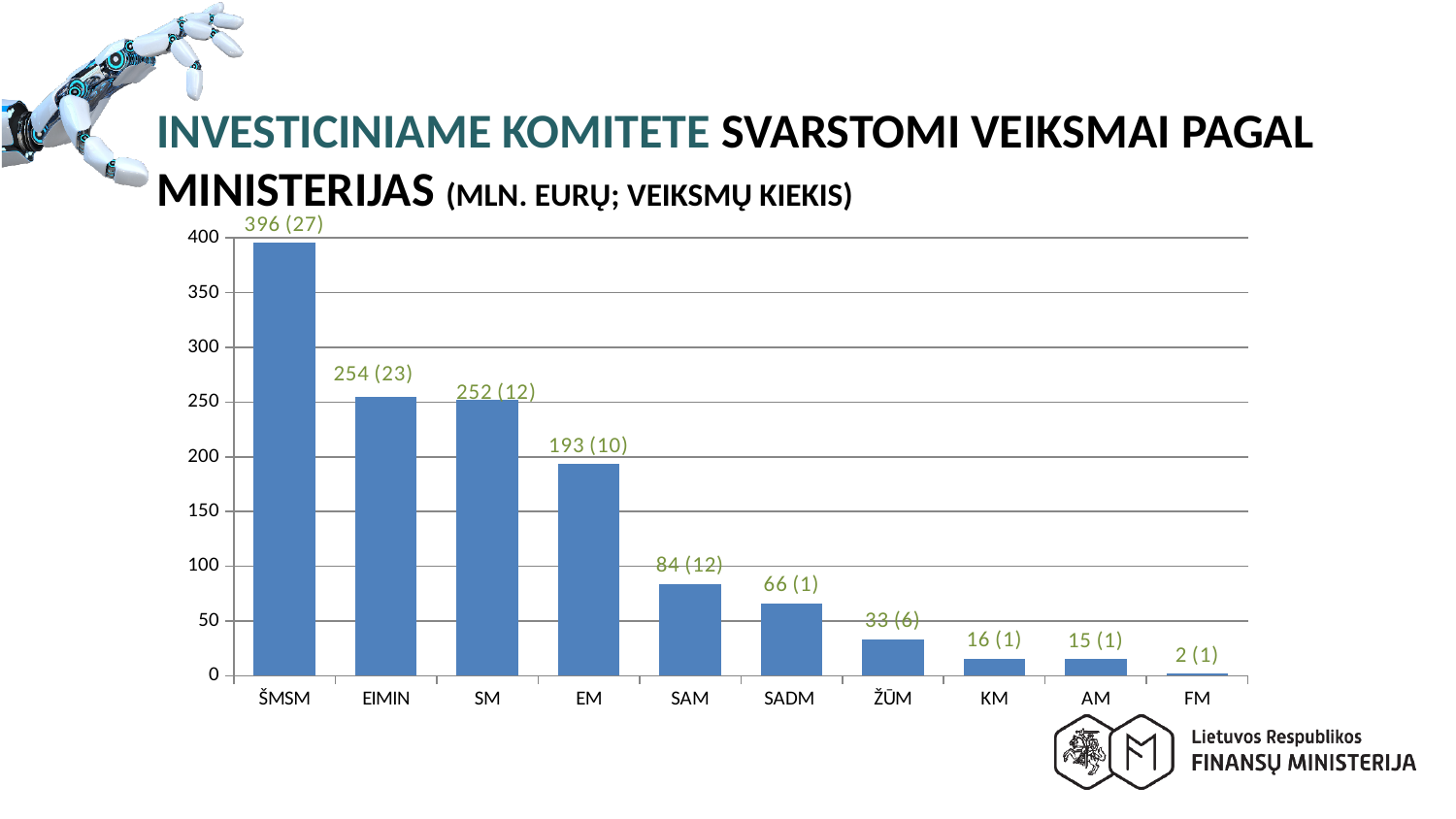
What is the data label shown for ŠMSM? 396 (27) What is the difference in mln eurų between ŠMSM (396) and EIMIN (254)? 142 What type of chart is shown on the slide? bar chart What is the data label shown for ŽŪM? 33 (6) Do the bar values rise or fall from left to right along the x axis? fall Which is larger, the value for SAM or the value for SADM? SAM Is the value for EM greater or less than 200? less Which ministry has the highest value in the chart? ŠMSM What is the data label shown for FM? 2 (1) What is the data label shown for EM? 193 (10) Which ministry has the lowest value in the chart? FM How many ministries (categories) are shown on the x axis of the chart? 10